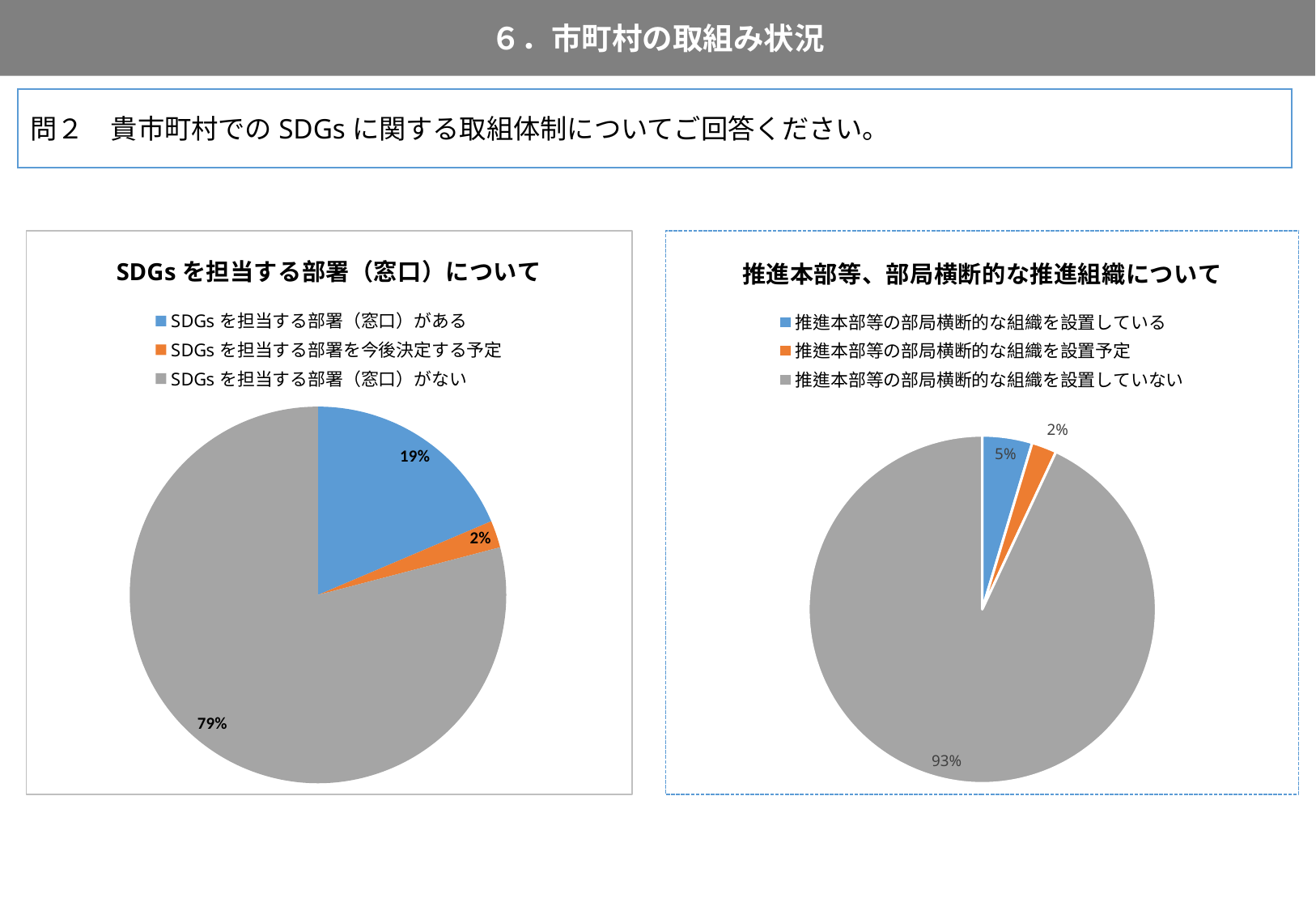
In the left chart titled 'SDGsを担当する部署（窓口）について', what percentage is shown for 'SDGsを担当する部署（窓口）がある'? 19% In the left chart titled 'SDGsを担当する部署（窓口）について', what percentage is shown for 'SDGsを担当する部署（窓口）がない'? 79% In the left chart titled 'SDGsを担当する部署（窓口）について', which category has the smallest slice? SDGsを担当する部署を今後決定する予定 What type of chart is the left chart titled 'SDGsを担当する部署（窓口）について'? Pie chart In the left chart titled 'SDGsを担当する部署（窓口）について', what colour is the slice for 'SDGsを担当する部署（窓口）がある'? Blue In the right chart titled '推進本部等、部局横断的な推進組織について', what percentage is shown for '推進本部等の部局横断的な組織を設置している'? 5% How many categories does the legend of the right chart titled '推進本部等、部局横断的な推進組織について' list? 3 In the right chart titled '推進本部等、部局横断的な推進組織について', which is larger: '推進本部等の部局横断的な組織を設置している' or '推進本部等の部局横断的な組織を設置予定'? 推進本部等の部局横断的な組織を設置している In the right chart titled '推進本部等、部局横断的な推進組織について', what percentage is shown for '推進本部等の部局横断的な組織を設置していない'? 93% In the left chart titled 'SDGsを担当する部署（窓口）について', what is the difference in percentage points between 'SDGsを担当する部署（窓口）がない' and 'SDGsを担当する部署（窓口）がある'? 60 In the left chart titled 'SDGsを担当する部署（窓口）について', what percentage is shown for 'SDGsを担当する部署を今後決定する予定'? 2% In the right chart titled '推進本部等、部局横断的な推進組織について', which category has the largest slice? 推進本部等の部局横断的な組織を設置していない